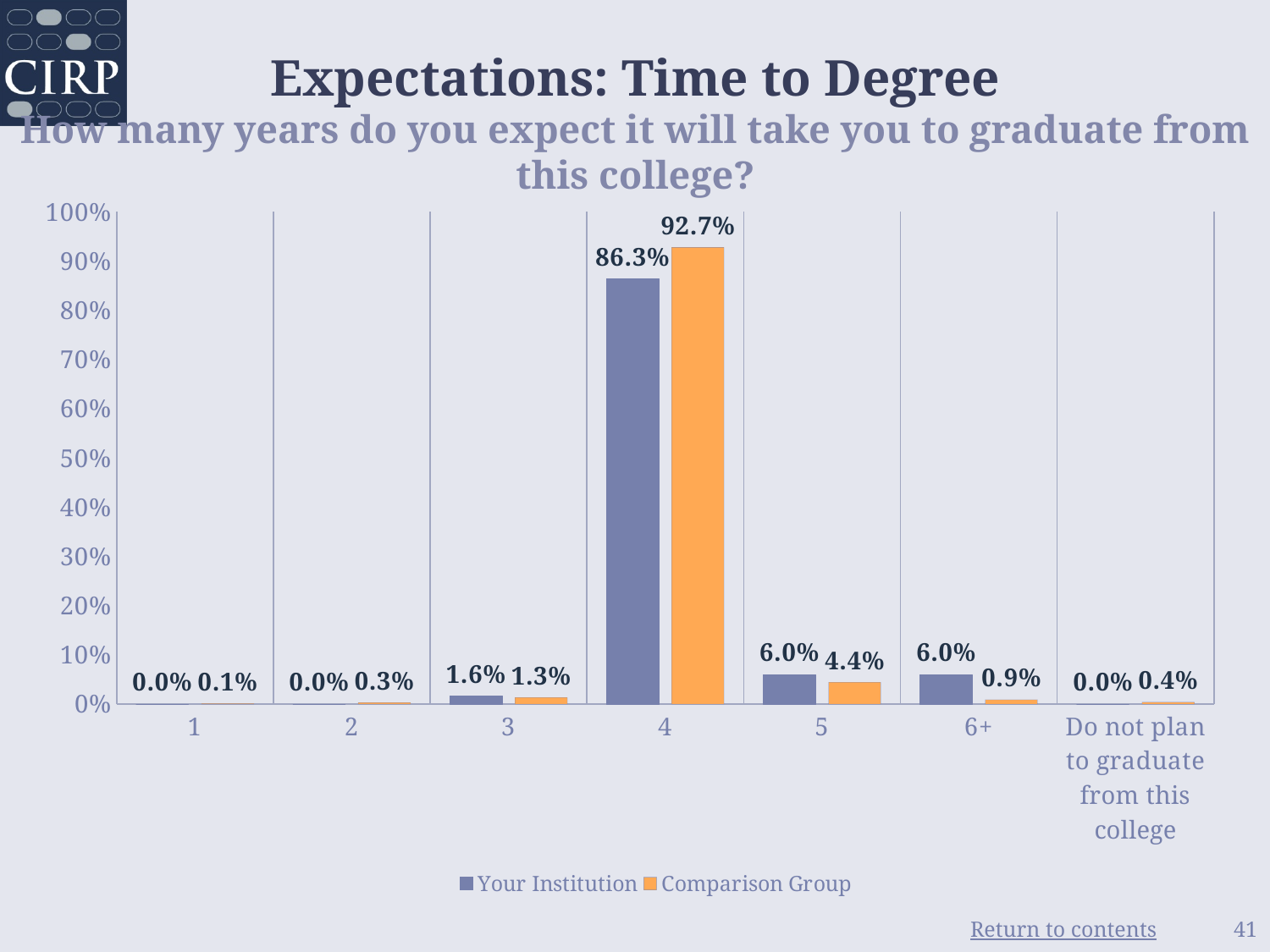
Which is larger in the 5 years category: Your Institution or Comparison Group? Your Institution Which category has the highest value for Comparison Group? 4 What is the value for Comparison Group in the 'Do not plan to graduate from this college' category? 0.4% How many series does the legend list? 2 What is the value for Comparison Group in the 4 years category? 92.7% What is the value for Your Institution in the 4 years category? 86.3% What is the value for Your Institution in the 6+ category? 6.0% What kind of chart is shown on the slide? bar chart Is the value for Your Institution in the 4 years category greater or less than 80%? greater What is the difference between Comparison Group and Your Institution in the 4 years category? 6.4% What is the title of the chart? How many years do you expect it will take you to graduate from this college? How many categories are shown on the x axis? 7